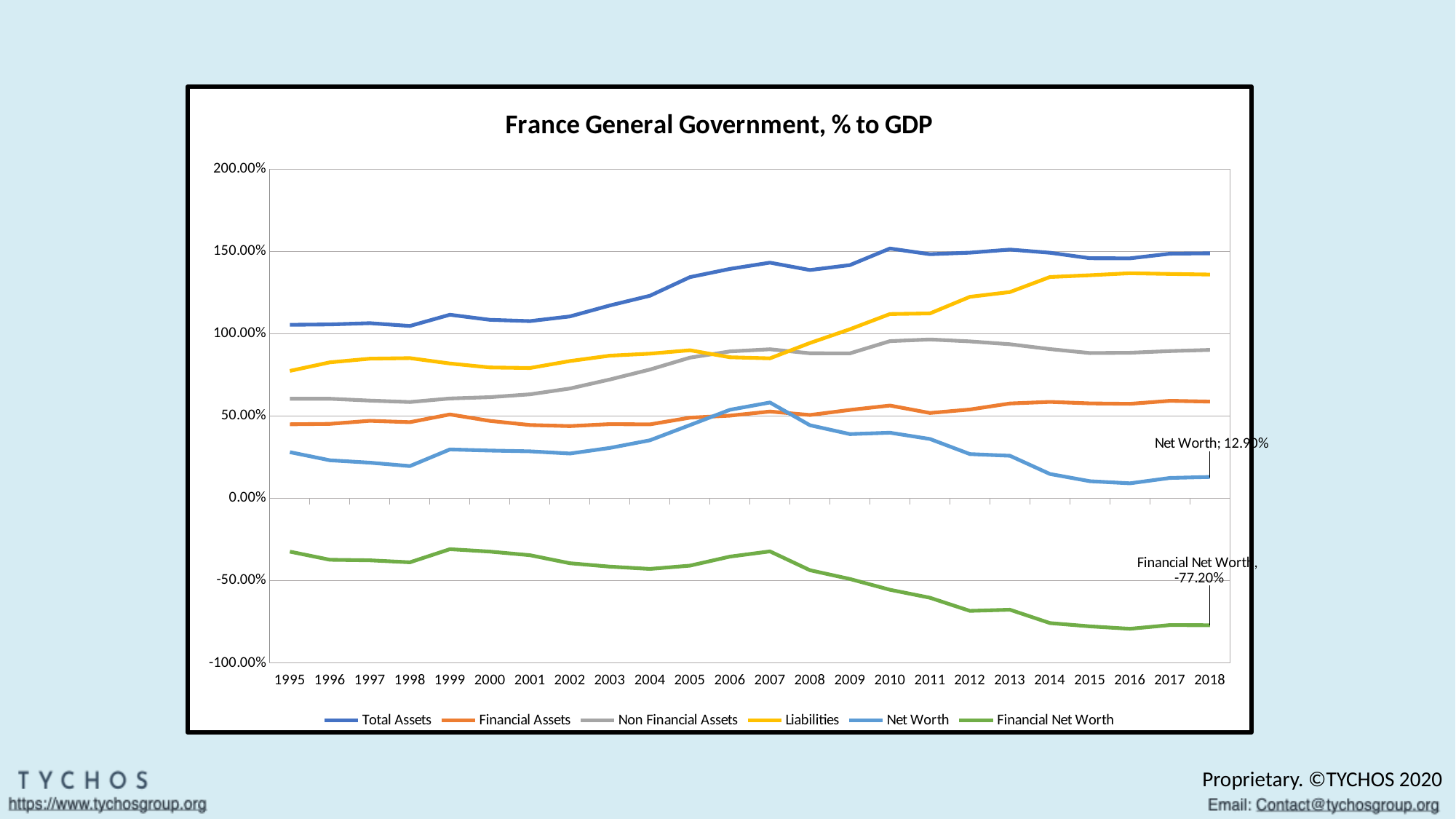
Is the value for Total Assets in 2018 greater or less than 100.00%? greater Is the value for Liabilities in 1995 greater or less than 100.00%? less Do the Liabilities values generally rise or fall from 1995 to 2018? rise What kind of chart is shown on the slide? line chart How many series does the legend list? 6 Which series has the highest value in 2018? Total Assets Which series has the lowest value in 2018? Financial Net Worth What is the difference between Net Worth and Financial Net Worth in 2018? 90.10% What is the value of Net Worth in 2018? 12.90% What is the value of Financial Net Worth in 2018? -77.20% In 2018, which is larger: Liabilities or Non Financial Assets? Liabilities How many years are plotted along the x axis? 24